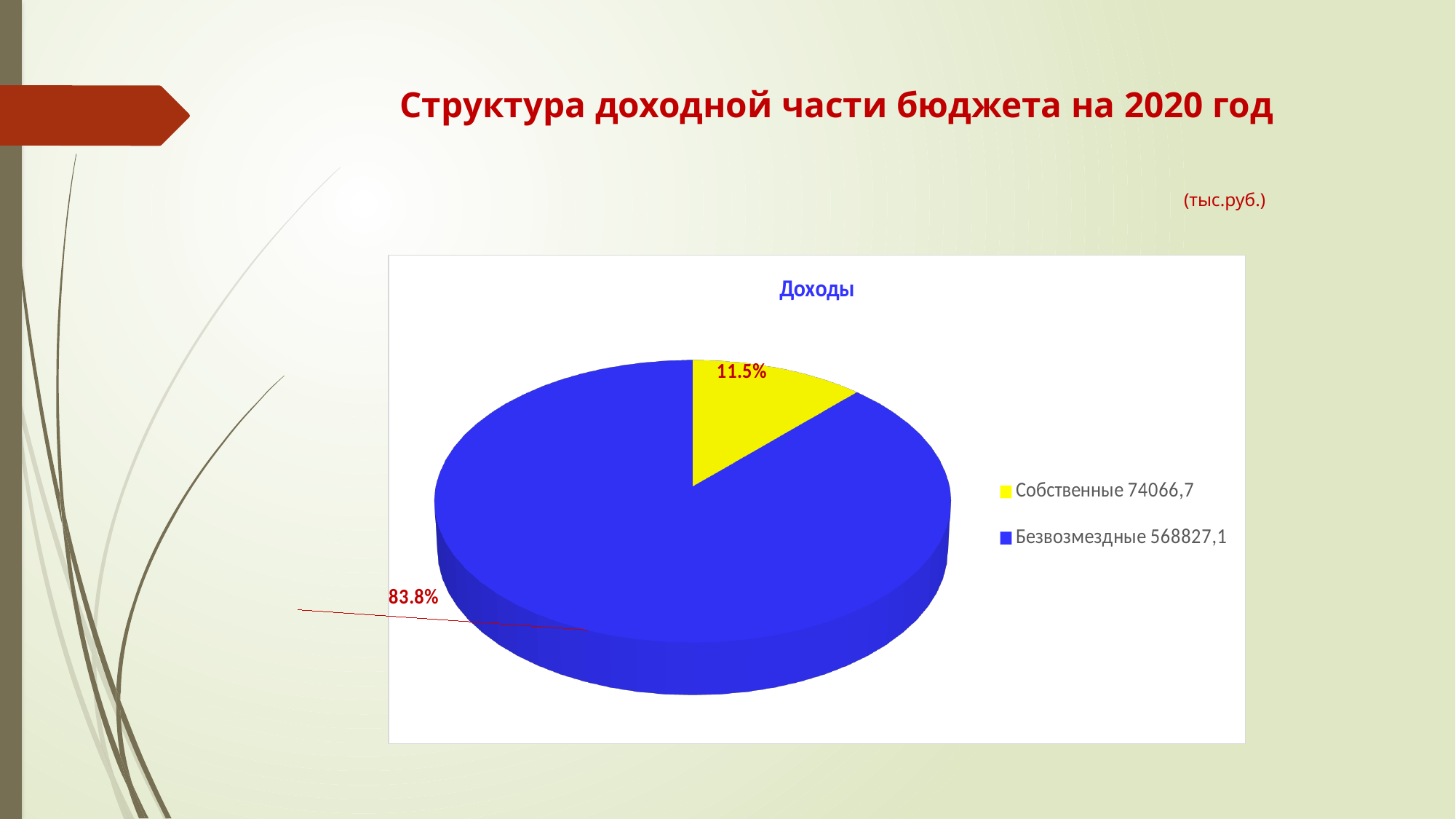
What percentage label is shown on the Безвозмездные slice? 83.8% Which category has the smallest share of the pie? Собственные What is the difference in percentage points between the Безвозмездные and Собственные slices? 72.3 What is the title of the chart? Доходы Which category has the largest share of the pie? Безвозмездные What colour is the Собственные slice? yellow How many slices does the pie chart have? 2 Which is larger, Собственные or Безвозмездные? Безвозмездные What value is given for Собственные in the legend? 74066,7 What kind of chart is shown on the slide? pie chart What value is given for Безвозмездные in the legend? 568827,1 What percentage label is shown on the Собственные slice? 11.5%